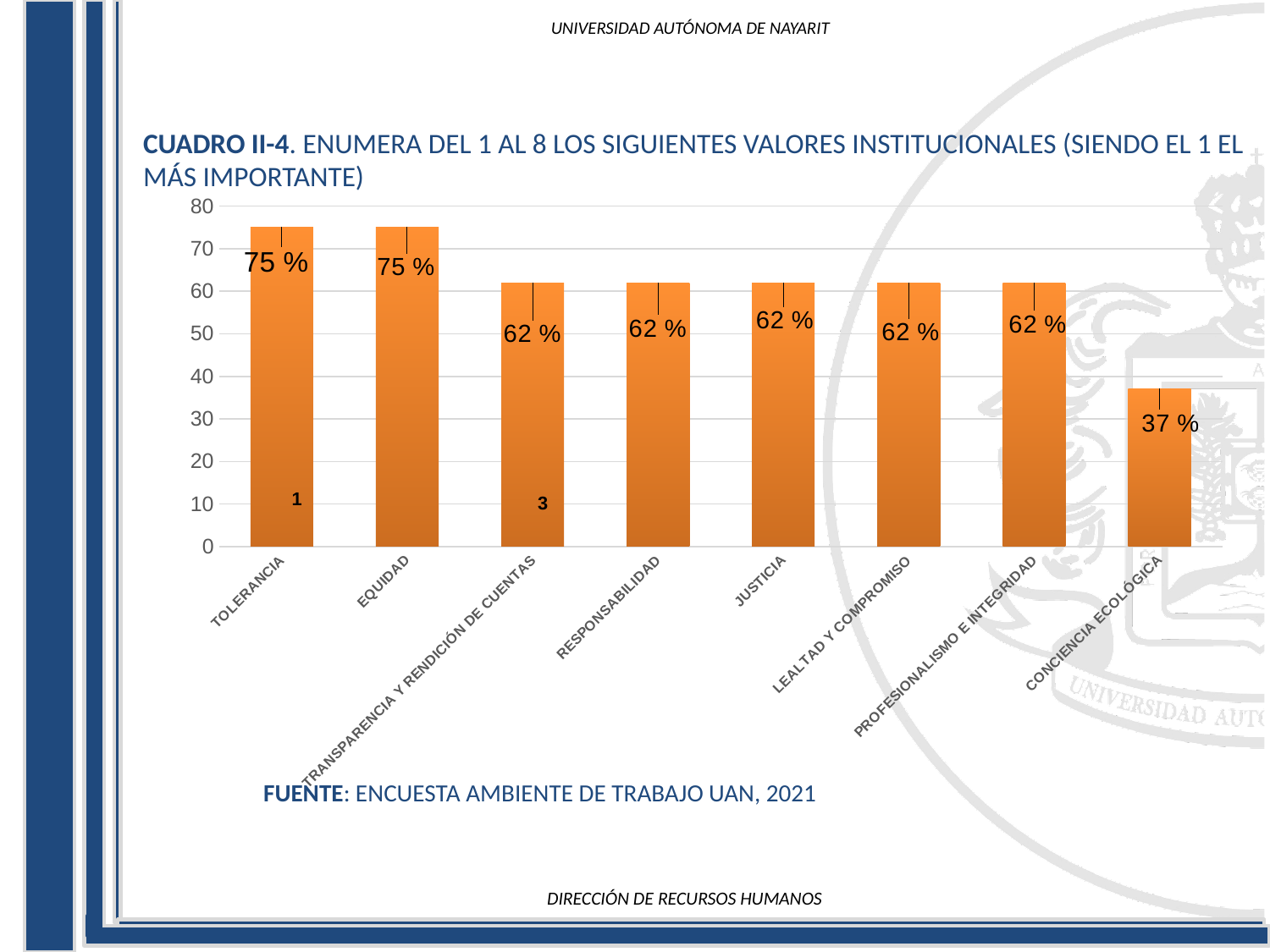
What is the value for JUSTICIA? 62 % What is the difference between the value for EQUIDAD and the value for LEALTAD Y COMPROMISO? 13 % What kind of chart is shown on the slide? bar chart Which is larger, the value for TOLERANCIA or the value for RESPONSABILIDAD? TOLERANCIA What is the value for TOLERANCIA? 75 % Which category has the lowest value? CONCIENCIA ECOLÓGICA Do the values rise or fall from left to right along the x axis? fall How many categories are shown on the x axis? 8 What source is cited below the chart? ENCUESTA AMBIENTE DE TRABAJO UAN, 2021 What is the value for CONCIENCIA ECOLÓGICA? 37 % What is the value for EQUIDAD? 75 % Is the value for CONCIENCIA ECOLÓGICA greater or less than 40? less